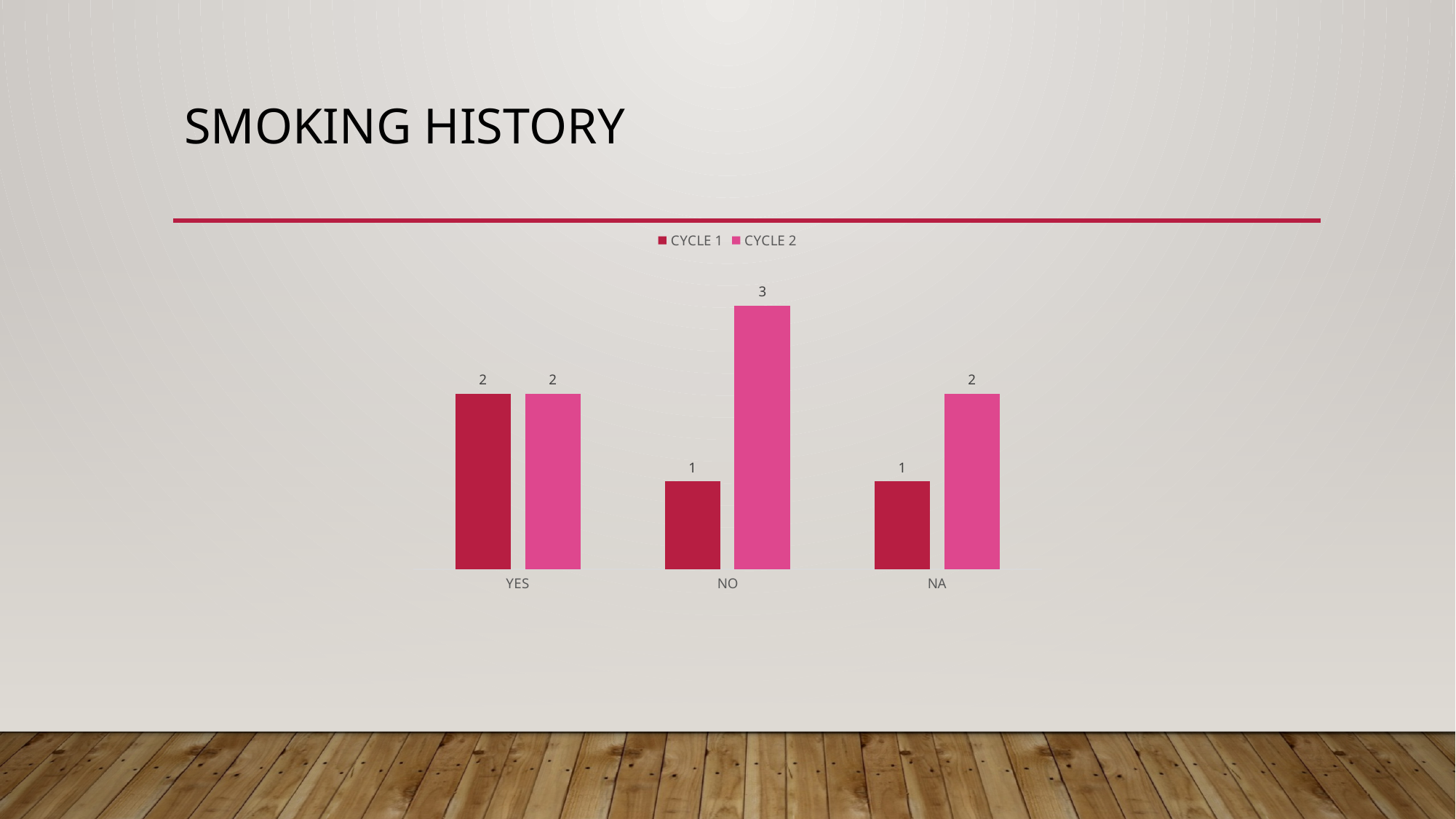
What is the value for CYCLE 2 in the NO category? 3 What kind of chart is shown on the slide? Bar chart What is the difference between CYCLE 2 and CYCLE 1 in the NO category? 2 How many categories are shown on the x axis? 3 Which category has the highest value for CYCLE 2? NO How many series does the legend list? 2 What is the value for CYCLE 2 in the NA category? 2 What is the value for CYCLE 1 in the YES category? 2 What is the value for CYCLE 1 in the NA category? 1 Which category has the highest value for CYCLE 1? YES Which is larger in the NA category, CYCLE 1 or CYCLE 2? CYCLE 2 What is the title of the slide containing the chart? SMOKING HISTORY